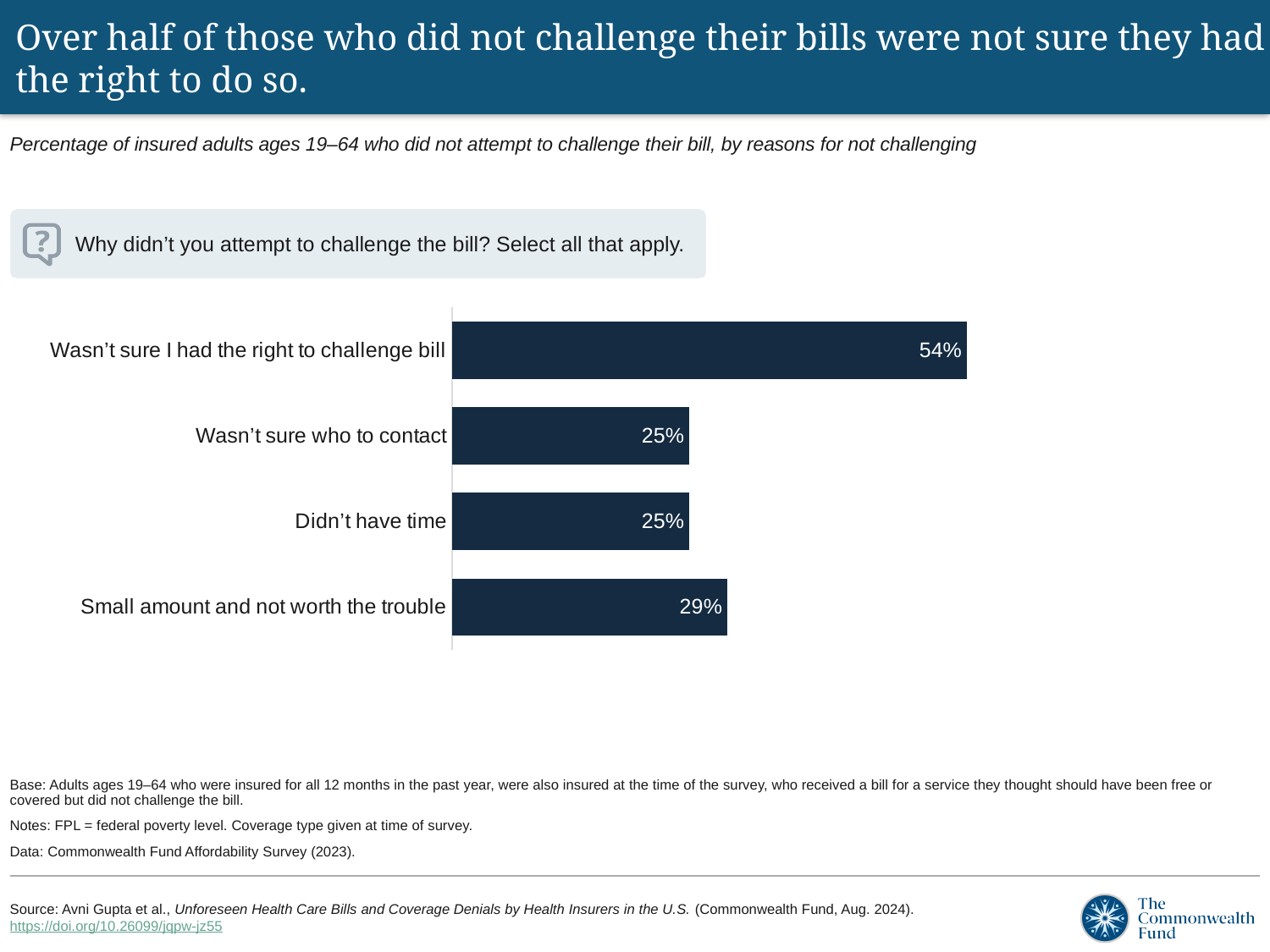
What is the value for "Small amount and not worth the trouble"? 29% What is the data source cited for the chart? Commonwealth Fund Affordability Survey (2023) Which reason for not challenging the bill has the highest percentage? Wasn't sure I had the right to challenge bill What percentage of insured adults who did not challenge their bill said they weren't sure they had the right to challenge the bill? 54% What is the difference between the percentage for "Wasn't sure I had the right to challenge bill" and "Small amount and not worth the trouble"? 25 percentage points Which is larger: the value for "Small amount and not worth the trouble" or the value for "Wasn't sure who to contact"? Small amount and not worth the trouble How many reasons for not challenging the bill are shown in the chart? 4 What is the difference between the values for "Wasn't sure I had the right to challenge bill" and "Wasn't sure who to contact"? 29 percentage points What is the value for "Didn't have time"? 25% Which two reasons have the same percentage? Wasn't sure who to contact and Didn't have time What survey question is shown above the chart? Why didn't you attempt to challenge the bill? Select all that apply. What kind of chart is shown on the slide? Bar chart